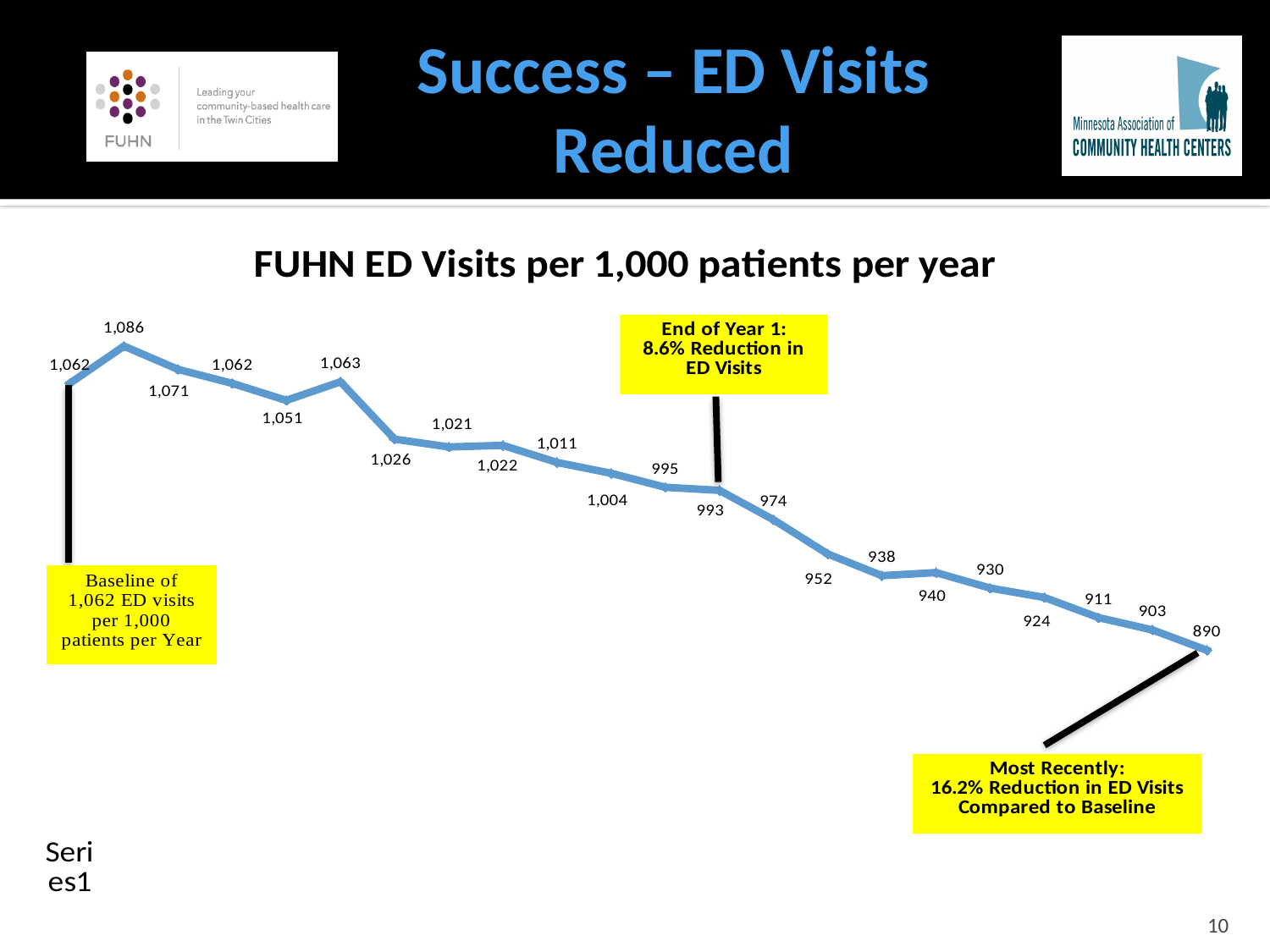
What is the difference between the first point (1,062) and the last point (890) on the line? 172 Which is larger, the second point on the line (1,086) or the last point (890)? 1,086 What is the value of the last (rightmost) point on the line? 890 How many data points are plotted on the line? 22 What is the lowest value plotted on the line? 890 How many series does the legend list? 1 What is the value of the first (leftmost) point on the line? 1,062 What kind of chart is shown on the slide? line chart What is the difference between the highest value (1,086) and the lowest value (890) on the line? 196 What is the highest value plotted on the line? 1,086 Overall, do the values rise or fall from left to right along the line? fall What is the title of the chart? FUHN ED Visits per 1,000 patients per year